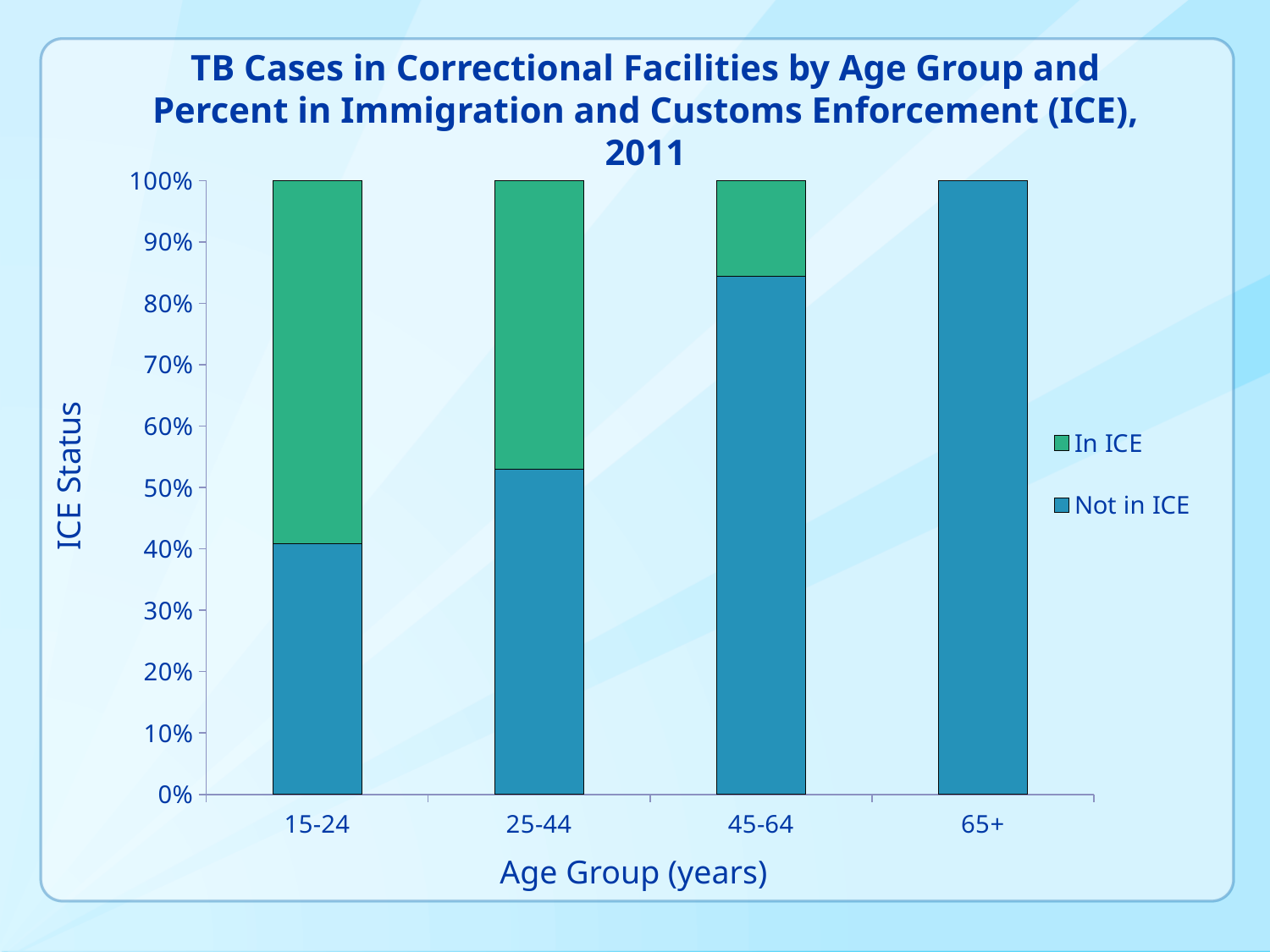
Which is larger for the 25-44 age group, the In ICE share or the Not in ICE share? Not in ICE How many age groups are shown on the x axis? 4 What kind of chart is shown on the slide? Stacked bar chart Which age group has the smallest Not in ICE share? 15-24 How many series does the legend list? 2 What are the two series listed in the legend? In ICE and Not in ICE Does the Not in ICE share rise or fall as age group increases along the x axis? rise What is the label of the x axis? Age Group (years) Which age group has the largest In ICE share? 15-24 Is the Not in ICE share for the 15-24 age group greater or less than 50%? less Is the Not in ICE share for the 45-64 age group greater or less than 80%? greater Which age group has the largest Not in ICE share? 65+